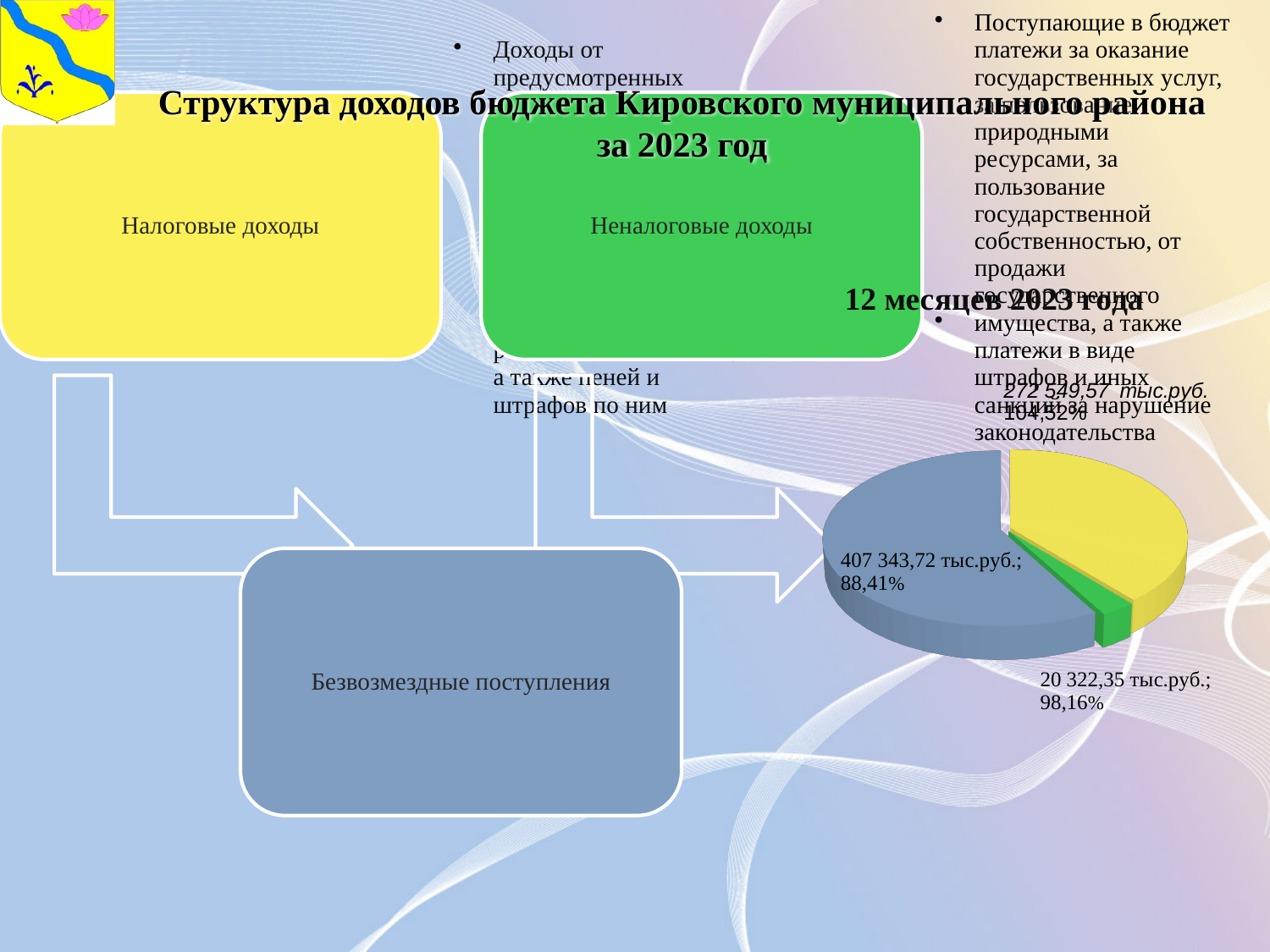
What percentage is printed on the blue slice of the pie chart? 88,41% Which slice of the pie chart has the smallest value in тыс.руб.? the green slice (20 322,35 тыс.руб.) Which slice of the pie chart has the largest value in тыс.руб.? the blue slice (407 343,72 тыс.руб.) What kind of chart is shown on the slide? pie chart How many slices does the pie chart have? 3 What value is printed on the blue slice of the pie chart? 407 343,72 тыс.руб. What percentage is printed on the yellow slice of the pie chart? 104,52% What is the difference in тыс.руб. between the blue slice and the green slice of the pie chart? 387 021,37 тыс.руб. What percentage is printed on the green slice of the pie chart? 98,16% What value is printed on the green slice of the pie chart? 20 322,35 тыс.руб. What value is printed on the yellow slice of the pie chart? 272 549,57 тыс.руб. Which is larger in тыс.руб., the yellow slice or the green slice of the pie chart? the yellow slice